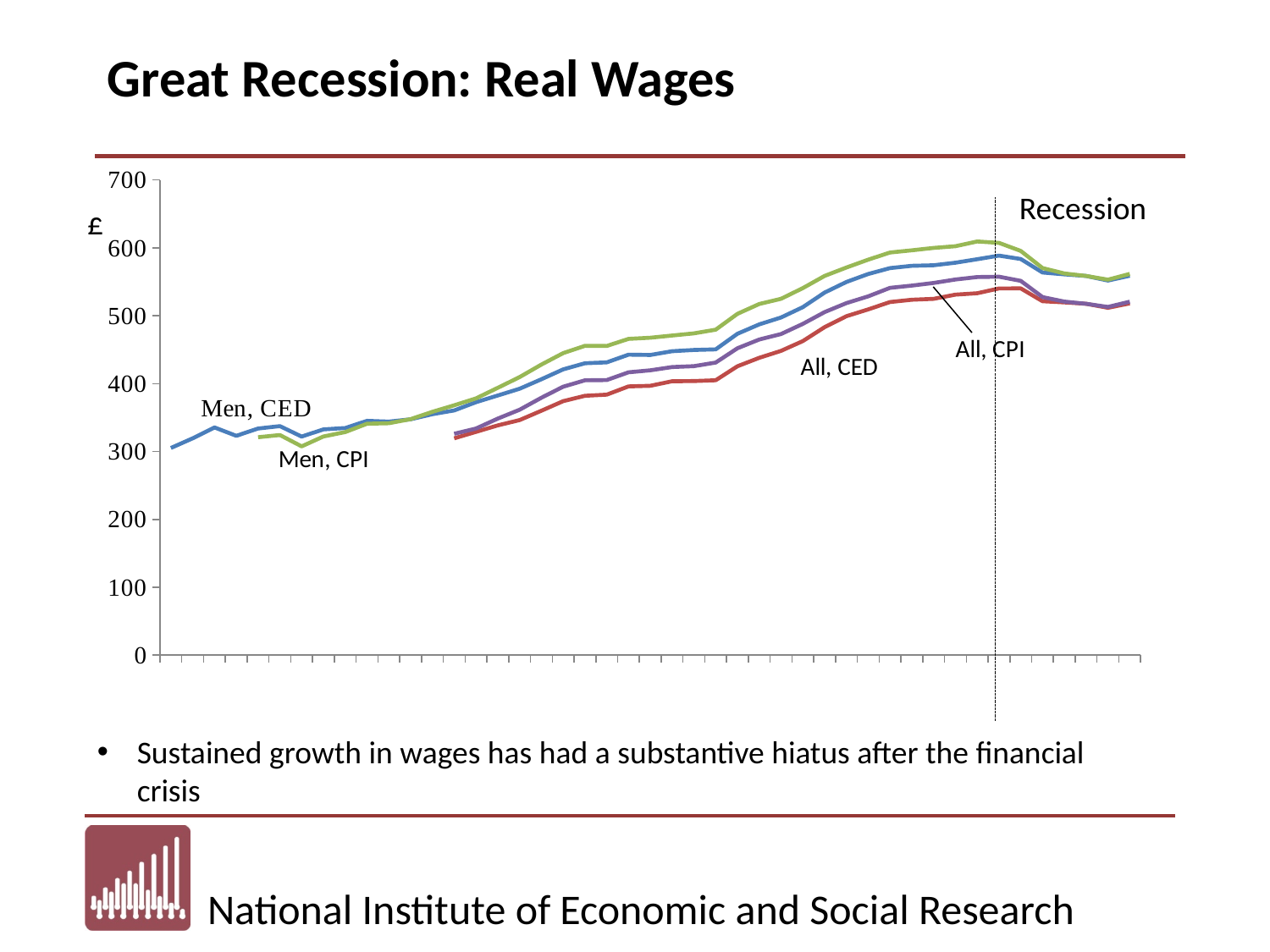
What is the title of the slide containing the chart? Great Recession: Real Wages Is the peak value of the highest line on the chart greater or less than 600? greater After the dotted vertical line, do the wage lines rise or fall? fall How many series (lines) are plotted on the chart? 4 Is the value of the All, CPI line at the right end of the chart greater or less than 600? less Do the wage lines generally rise or fall from left to right before the dotted vertical line? rise Is the peak value of the All, CPI line greater or less than 500? greater What unit is shown on the vertical axis of the chart? £ What kind of chart is shown on the slide? line chart What is the highest tick value shown on the vertical axis? 700